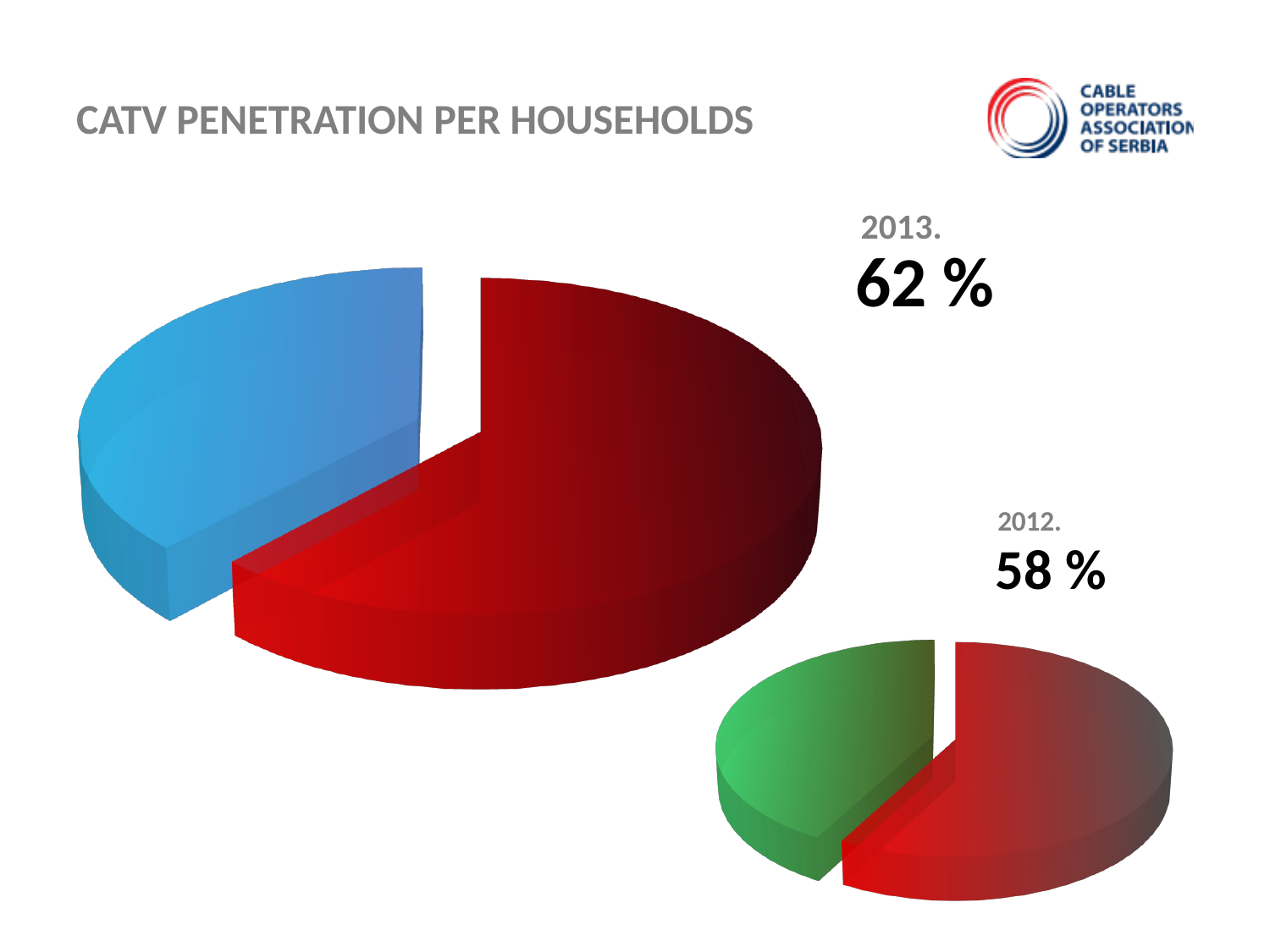
How many pie charts are shown on the slide? 2 Is the 2013 penetration value greater or less than 50%? greater Which year is represented by the larger pie chart on the slide? 2013 By how many percentage points did CATV penetration change from 2012 to 2013? 4 percentage points What is the title of the slide? CATV PENETRATION PER HOUSEHOLDS What kind of charts are shown on the slide? pie charts Did CATV penetration per households rise or fall from 2012 to 2013? rise What is the CATV penetration per households shown for 2012? 58 % Which year shows the higher CATV penetration, 2012 or 2013? 2013 Is the 2012 penetration value greater or less than 60%? less What is the CATV penetration per households shown for 2013? 62 %